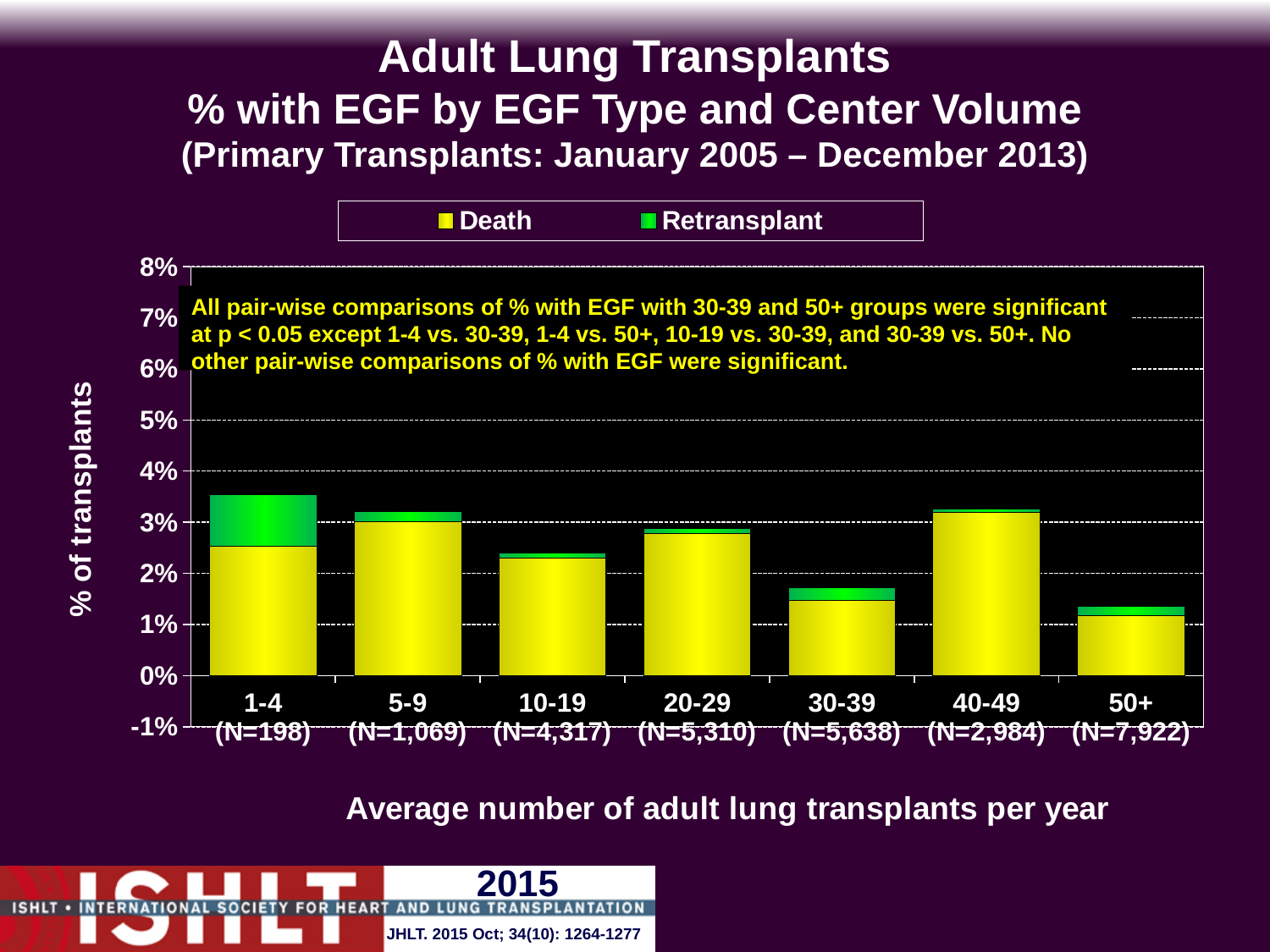
Is the total % with EGF for the 1-4 group greater or less than 3%? greater Is the total % with EGF for the 30-39 group greater or less than 2%? less Which center volume group has the highest total % with EGF? 1-4 Which has a larger total % with EGF, the 20-29 group or the 10-19 group? 20-29 What kind of chart is shown on the slide? Stacked bar chart What is the x-axis title of the chart? Average number of adult lung transplants per year How many center volume categories are shown on the x axis? 7 Is the total % with EGF for the 40-49 group greater or less than 3%? greater Which center volume group has the lowest total % with EGF? 50+ Which center volume group has the largest Retransplant segment? 1-4 How many series does the legend list? 2